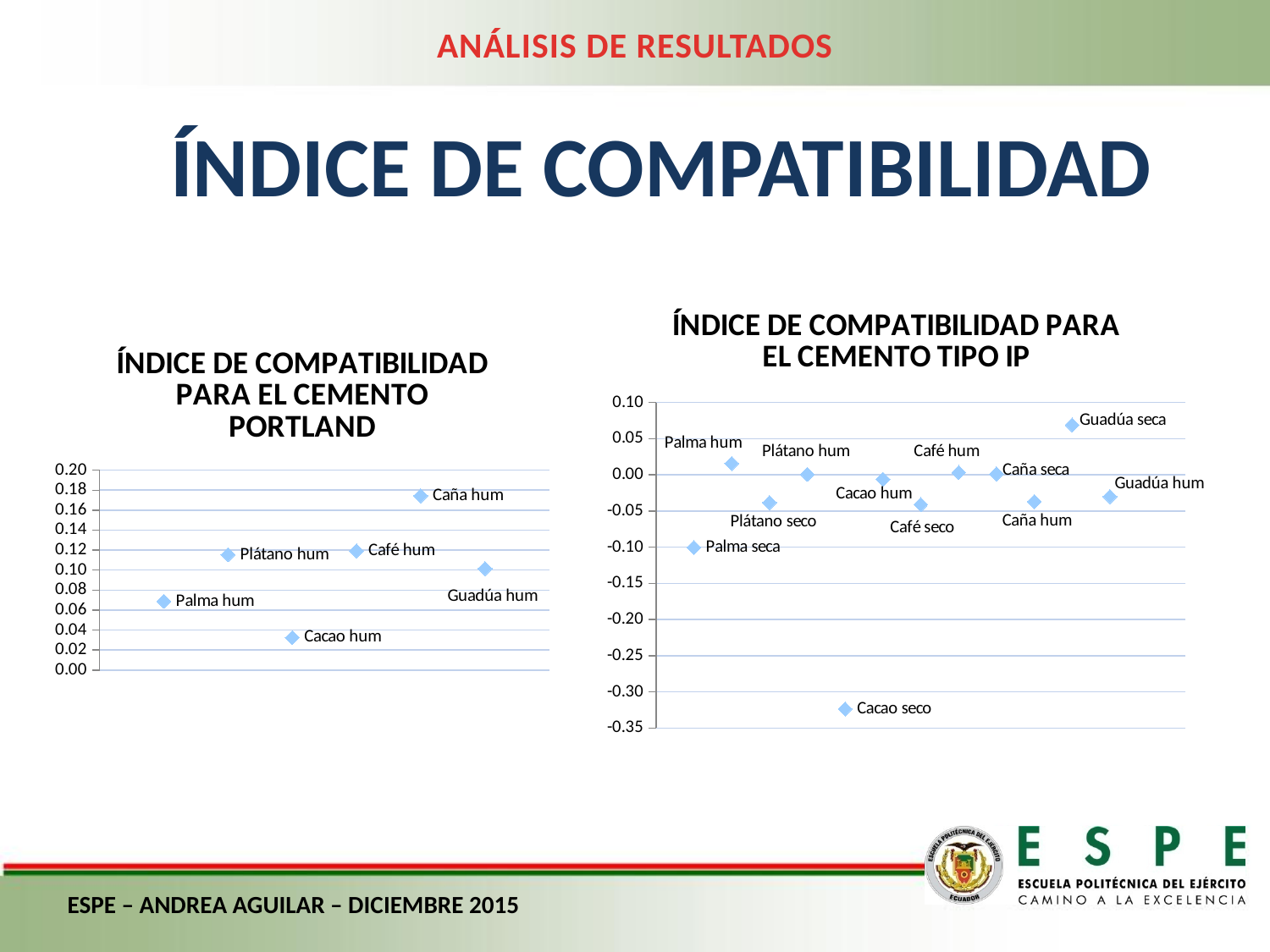
In the chart titled 'ÍNDICE DE COMPATIBILIDAD PARA EL CEMENTO PORTLAND', which material has the lowest compatibility index? Cacao hum In the chart titled 'ÍNDICE DE COMPATIBILIDAD PARA EL CEMENTO PORTLAND', which is larger, the value for Caña hum or the value for Guadúa hum? Caña hum What kind of chart is the one titled 'ÍNDICE DE COMPATIBILIDAD PARA EL CEMENTO TIPO IP'? Scatter chart In the chart titled 'ÍNDICE DE COMPATIBILIDAD PARA EL CEMENTO PORTLAND', how many data points are plotted? 6 In the chart titled 'ÍNDICE DE COMPATIBILIDAD PARA EL CEMENTO TIPO IP', which is larger, the value for Palma seca or the value for Plátano seco? Plátano seco In the chart titled 'ÍNDICE DE COMPATIBILIDAD PARA EL CEMENTO TIPO IP', how many data points are plotted? 12 In the chart titled 'ÍNDICE DE COMPATIBILIDAD PARA EL CEMENTO PORTLAND', which material has the highest compatibility index? Caña hum In the chart titled 'ÍNDICE DE COMPATIBILIDAD PARA EL CEMENTO TIPO IP', which material has the highest compatibility index? Guadúa seca In the chart titled 'ÍNDICE DE COMPATIBILIDAD PARA EL CEMENTO TIPO IP', which material has the lowest compatibility index? Cacao seco In the chart titled 'ÍNDICE DE COMPATIBILIDAD PARA EL CEMENTO PORTLAND', is the value for Caña hum greater or less than 0.16? greater In the chart titled 'ÍNDICE DE COMPATIBILIDAD PARA EL CEMENTO TIPO IP', is the value for Cacao seco greater or less than -0.30? less In the chart titled 'ÍNDICE DE COMPATIBILIDAD PARA EL CEMENTO PORTLAND', is the value for Cacao hum greater or less than 0.04? less